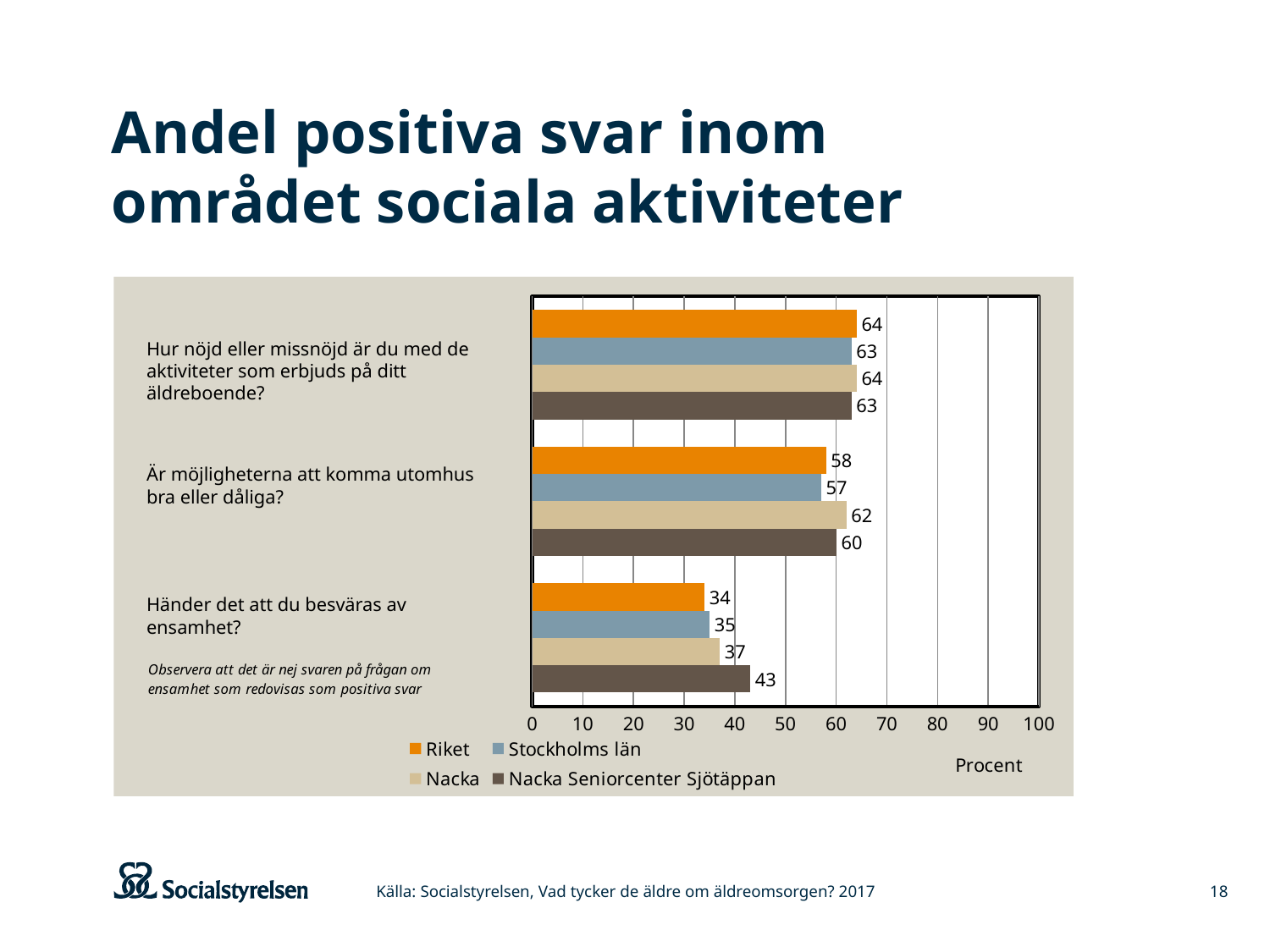
What kind of chart is shown on the slide? Bar chart Which series has the highest value on the question "Händer det att du besväras av ensamhet?"? Nacka Seniorcenter Sjötäppan On the question "Är möjligheterna att komma utomhus bra eller dåliga?", which is larger: the value for Nacka or the value for Nacka Seniorcenter Sjötäppan? Nacka What value is shown for Riket on the question "Är möjligheterna att komma utomhus bra eller dåliga?"? 58 What is the label of the horizontal axis? Procent What value is shown for Stockholms län on the question "Hur nöjd eller missnöjd är du med de aktiviteter som erbjuds på ditt äldreboende?"? 63 How many series does the legend list? 4 Which series has the lowest value on the question "Är möjligheterna att komma utomhus bra eller dåliga?"? Stockholms län Is the value for Riket on the question "Händer det att du besväras av ensamhet?" greater or less than 40? less What value is shown for Nacka on the question "Är möjligheterna att komma utomhus bra eller dåliga?"? 62 What is the difference between the Nacka Seniorcenter Sjötäppan value and the Riket value on the question "Händer det att du besväras av ensamhet?"? 9 What value is shown for Nacka Seniorcenter Sjötäppan on the question "Händer det att du besväras av ensamhet?"? 43